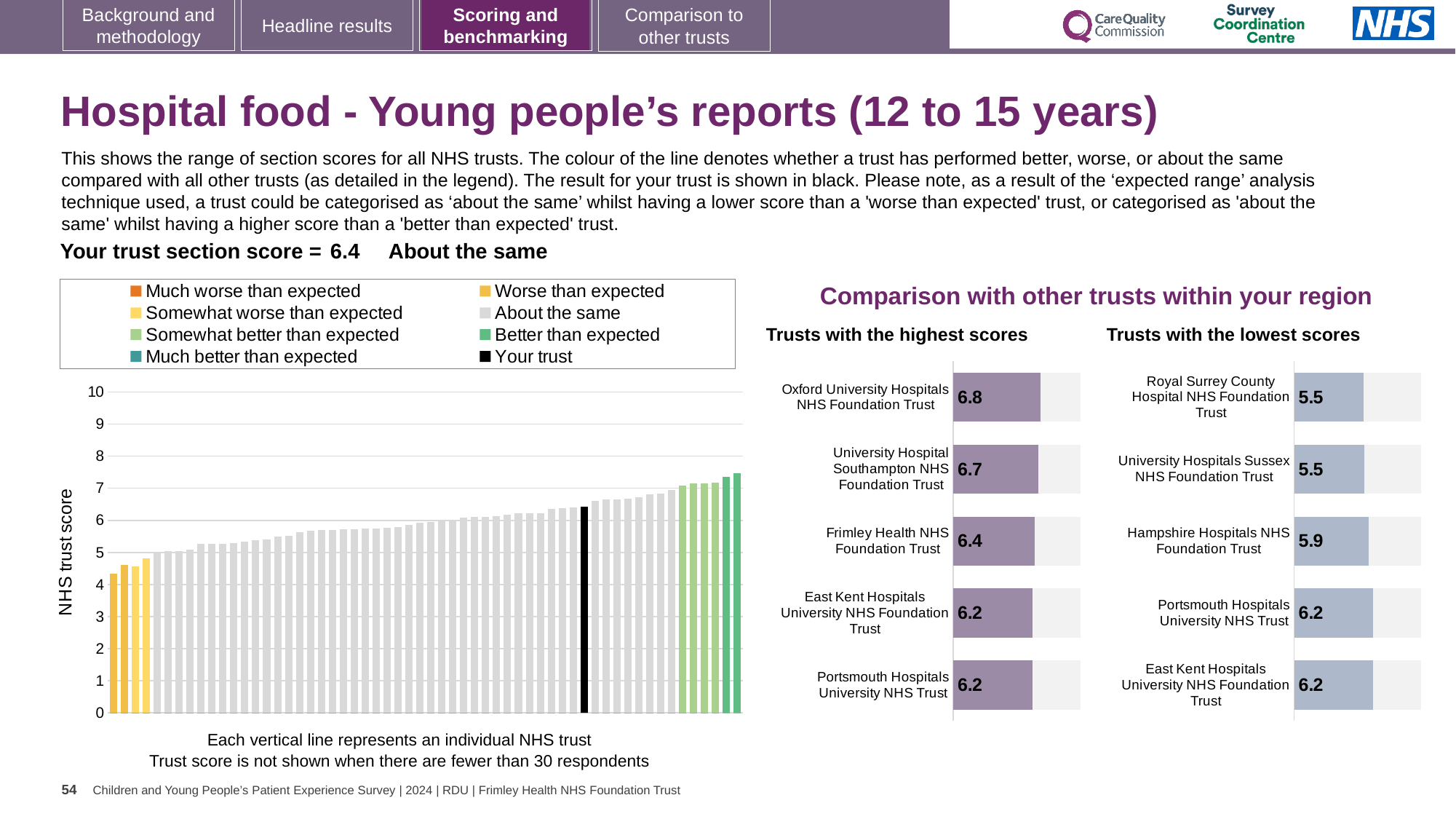
In the large 'NHS trust score' chart on the left, is the value of the lowest bar greater or less than 5? less In the 'Trusts with the lowest scores' chart, what is the difference between the scores of Hampshire Hospitals NHS Foundation Trust and Royal Surrey County Hospital NHS Foundation Trust? 0.4 How many trusts are listed in the 'Trusts with the lowest scores' chart? 5 In the 'Trusts with the lowest scores' chart, which has the larger score: Hampshire Hospitals NHS Foundation Trust or Portsmouth Hospitals University NHS Trust? Portsmouth Hospitals University NHS Trust In the 'Trusts with the highest scores' chart, which trust has the highest score? Oxford University Hospitals NHS Foundation Trust In the 'Trusts with the highest scores' chart, what is the difference between the scores of Oxford University Hospitals NHS Foundation Trust and Frimley Health NHS Foundation Trust? 0.4 In the 'Trusts with the lowest scores' chart, what is the score for Hampshire Hospitals NHS Foundation Trust? 5.9 What kind of chart is the large 'NHS trust score' chart on the left? bar chart In the large 'NHS trust score' chart on the left, is the value of the black bar (your trust) greater or less than 6? greater In the 'Trusts with the highest scores' chart, what is the score for Oxford University Hospitals NHS Foundation Trust? 6.8 How many entries does the legend of the large 'NHS trust score' chart on the left list? 8 In the 'Trusts with the highest scores' chart, what is the score for University Hospital Southampton NHS Foundation Trust? 6.7